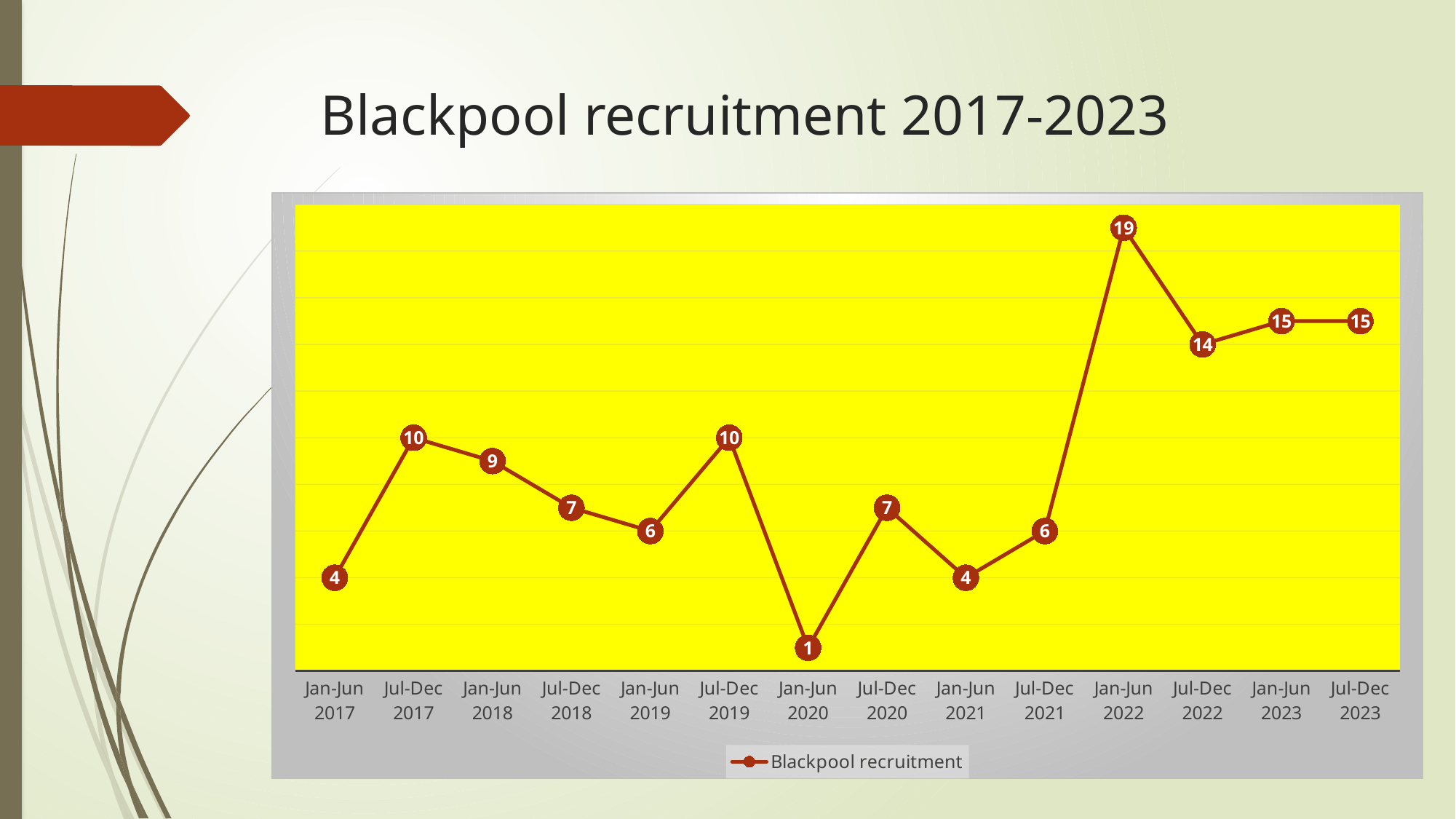
What is the difference between the values for Jul-Dec 2019 and Jan-Jun 2020? 9 What is the title of the slide? Blackpool recruitment 2017-2023 Which is larger, the value for Jul-Dec 2017 or the value for Jan-Jun 2018? Jul-Dec 2017 How many series does the legend list? 1 What is the value for Jan-Jun 2020? 1 Which period has the lowest value? Jan-Jun 2020 What is the difference between the values for Jan-Jun 2022 and Jul-Dec 2022? 5 What kind of chart is shown? Line chart How many periods are plotted on the x axis? 14 What is the value for Jul-Dec 2022? 14 Which period has the highest value? Jan-Jun 2022 What is the value for Jan-Jun 2017? 4